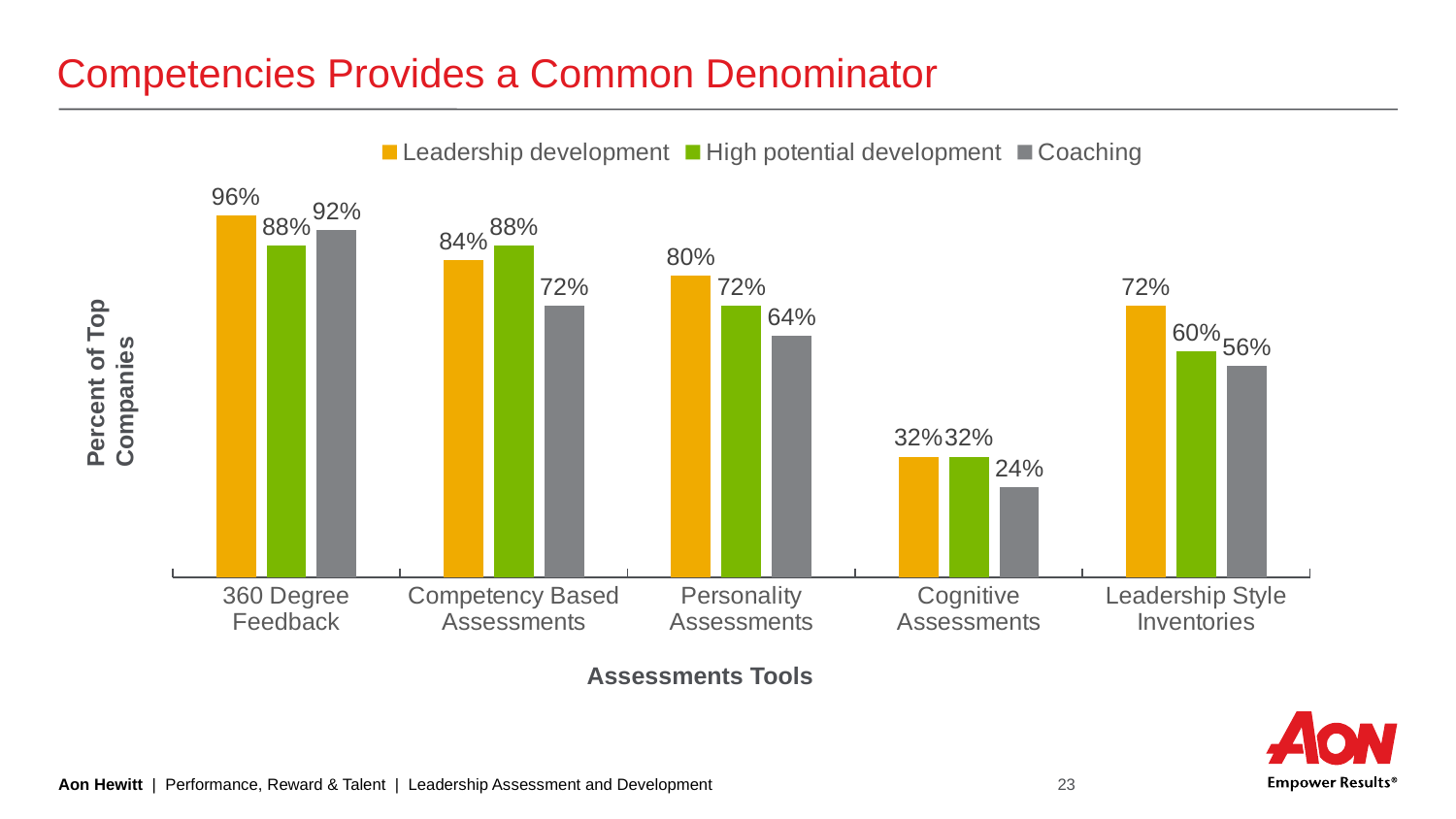
What is the difference between the Leadership development and Coaching values for Personality Assessments? 16% What kind of chart is shown on the slide? Bar chart What is the Leadership development value for 360 Degree Feedback? 96% What is the High potential development value for Leadership Style Inventories? 60% What is the Coaching value for Cognitive Assessments? 24% How many series does the legend list? 3 How many assessment tools are shown on the x axis? 5 Which assessment tool has the lowest Coaching value? Cognitive Assessments What is the label of the y axis? Percent of Top Companies For Competency Based Assessments, which is larger: the High potential development value or the Coaching value? High potential development Which colour represents Coaching in the legend? Grey Which assessment tool has the highest Leadership development value? 360 Degree Feedback